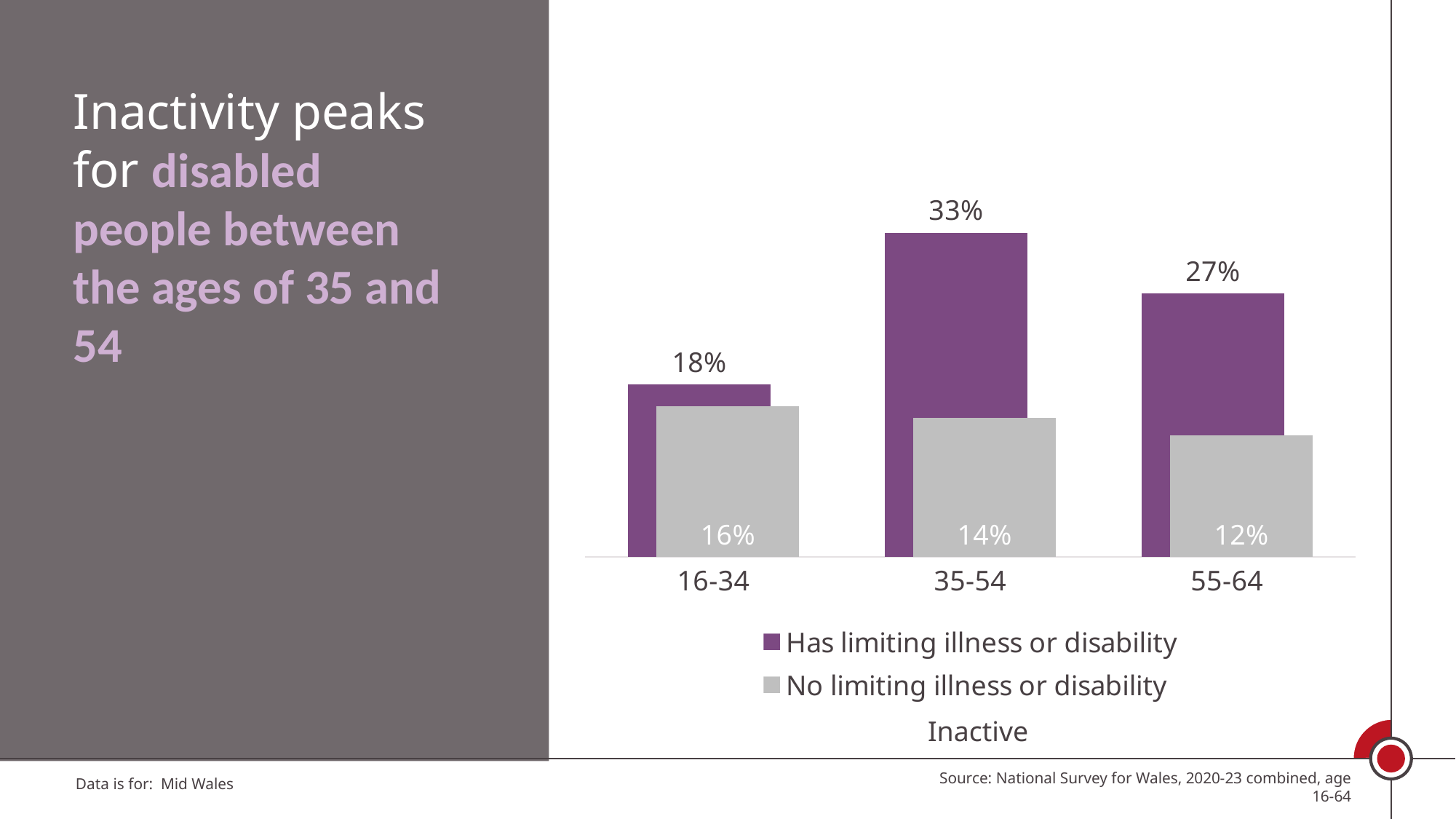
What is the inactivity value for people aged 35-54 who have a limiting illness or disability? 33% What kind of chart is shown on the slide? Bar chart Do the inactivity values for people with no limiting illness or disability rise or fall across the age groups from 16-34 to 55-64? Fall What is the inactivity value for people aged 16-34 with no limiting illness or disability? 16% How many series does the legend list? 2 What colour are the bars for the 'Has limiting illness or disability' series? Purple Which is larger: the inactivity value for 16-34 year olds with a limiting illness or disability, or for 16-34 year olds with no limiting illness or disability? Has limiting illness or disability How many age groups are shown on the x axis? 3 What is the difference between the inactivity values for people with and without a limiting illness or disability in the 35-54 age group? 19 percentage points Which age group has the lowest inactivity value for people with no limiting illness or disability? 55-64 What is the inactivity value for people aged 55-64 who have a limiting illness or disability? 27% Which age group has the highest inactivity value for people with a limiting illness or disability? 35-54